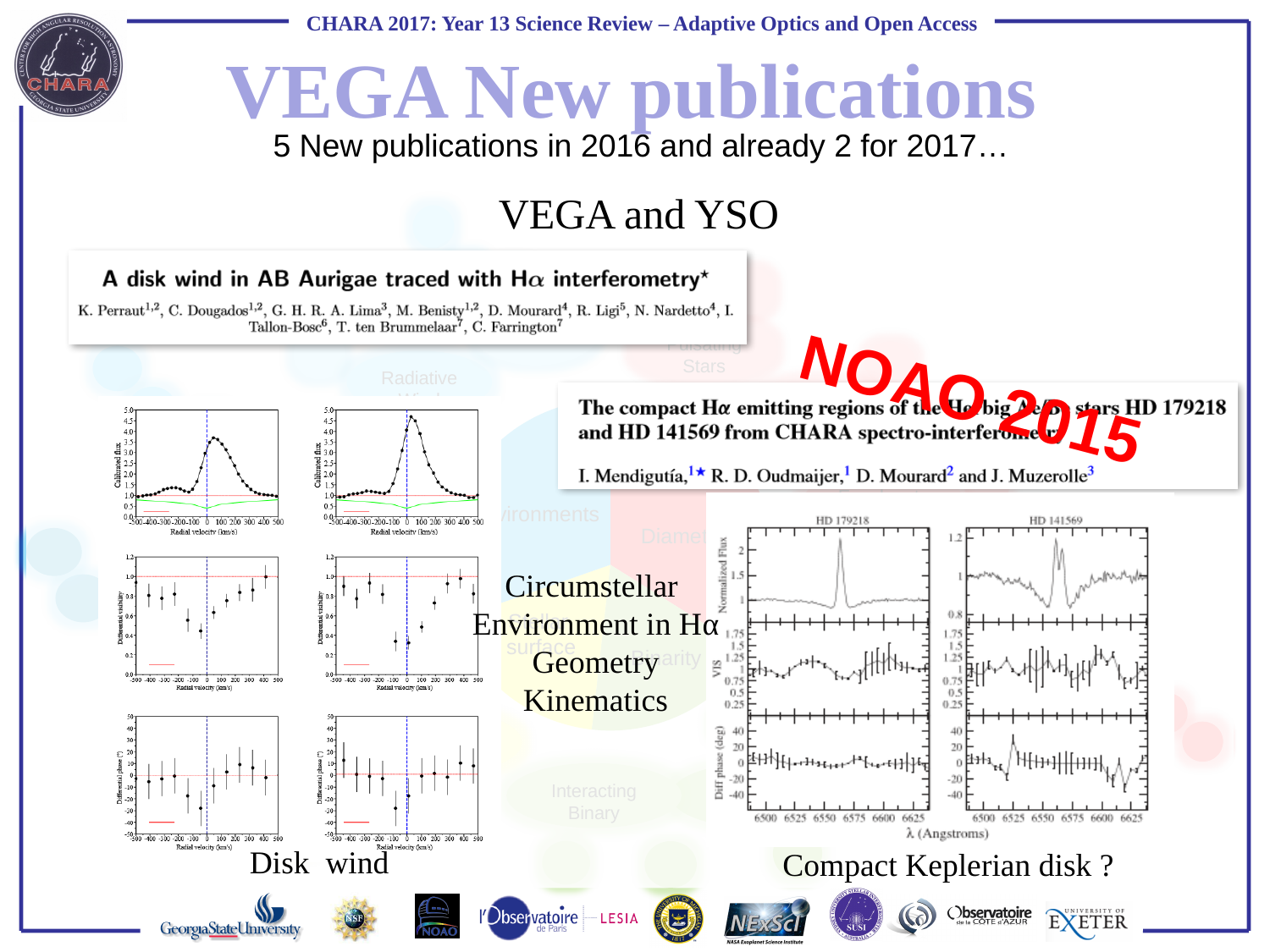
What is the x-axis label of the plots in the left-hand figure? Radial velocity (km/s) What is the x-axis label of the plots in the right-hand figure? λ (Angstroms) In the right-hand figure, is the peak normalized flux for HD 179218 greater or less than 1.5? greater In the right-hand figure, which star's normalized flux reaches a higher peak, HD 179218 or HD 141569? HD 179218 In the left-hand figure, is the peak calibrated flux in the top-left panel greater or less than 3.0? greater In the right-hand figure, is the peak normalized flux for HD 141569 greater or less than 1? greater How many individual plot panels make up the left-hand figure under 'Disk wind'? 6 How many stars are plotted as separate columns in the right-hand figure? 2 In the left-hand figure, which top-row calibrated flux profile reaches a higher peak, the left panel or the right panel? the right panel